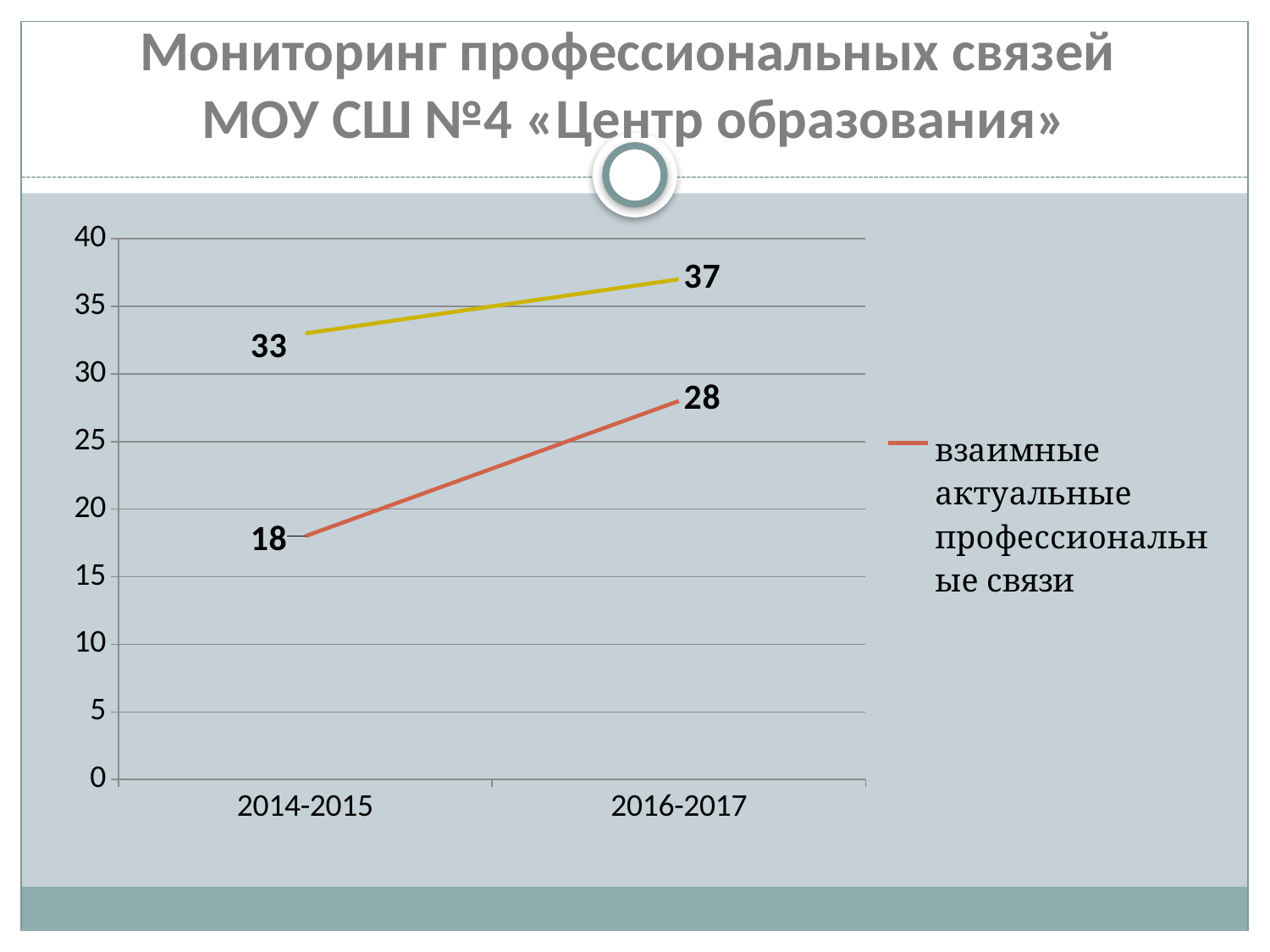
In 2016-2017, which is larger: the yellow line or the series "взаимные актуальные профессиональные связи"? the yellow line What type of chart is shown on the slide? line chart What is the value of the series "взаимные актуальные профессиональные связи" for 2016-2017? 28 How many series does the legend list? 1 What is the value of the yellow line for 2014-2015? 33 What is the difference between the yellow line and the series "взаимные актуальные профессиональные связи" in 2014-2015? 15 Does the series "взаимные актуальные профессиональные связи" rise or fall from 2014-2015 to 2016-2017? rise How many periods are shown on the x axis? 2 What is the value of the yellow line for 2016-2017? 37 By how much did the series "взаимные актуальные профессиональные связи" change from 2014-2015 to 2016-2017? 10 By how much did the yellow line change from 2014-2015 to 2016-2017? 4 What is the value of the series "взаимные актуальные профессиональные связи" for 2014-2015? 18